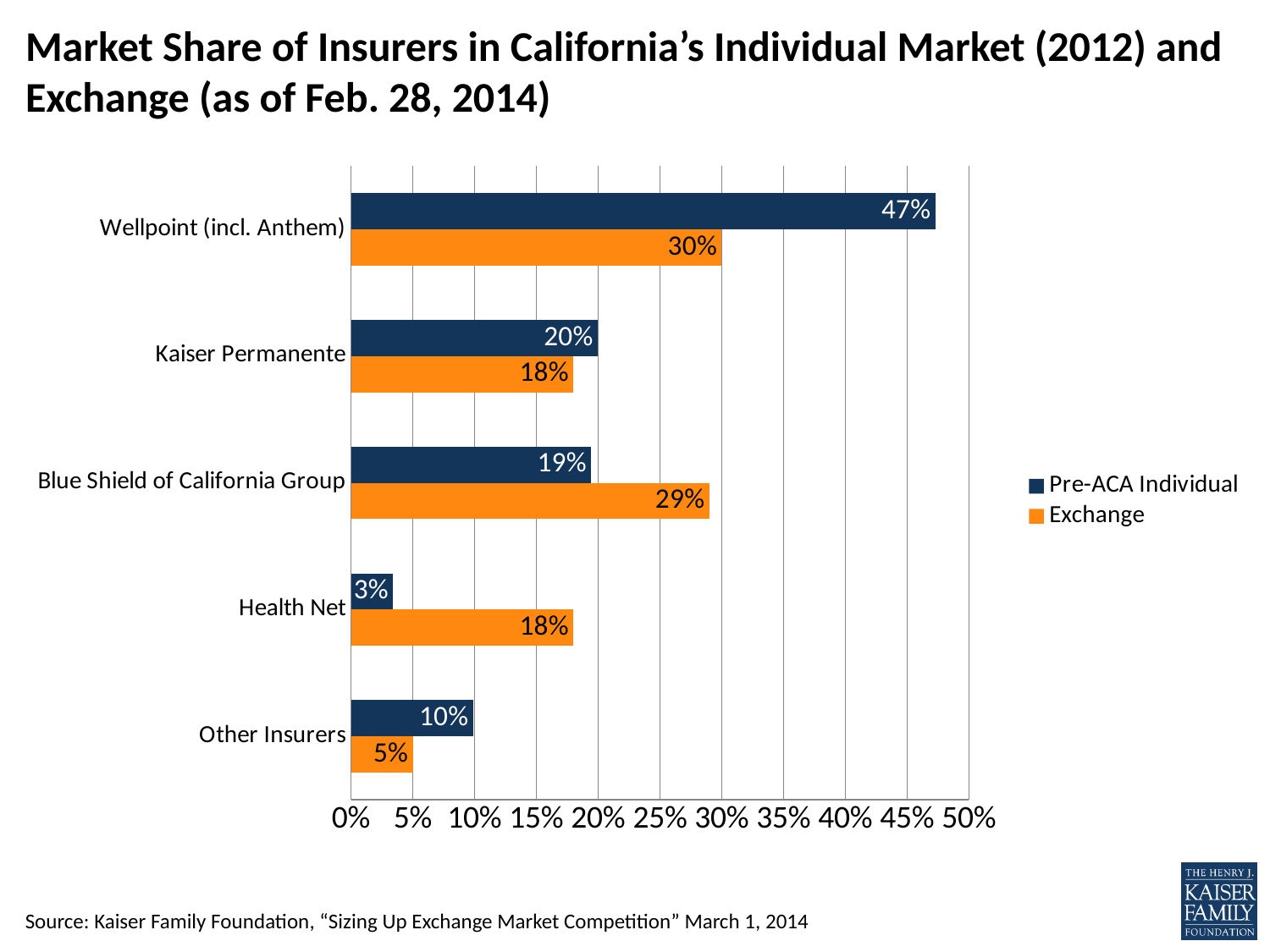
What kind of chart is shown on the slide? Bar chart Which is larger for Blue Shield of California Group: the Pre-ACA Individual share or the Exchange share? Exchange What is the Exchange market share for Blue Shield of California Group? 29% Which colour represents the Exchange series? Orange Which insurer has the lowest Pre-ACA Individual market share? Health Net What is the Pre-ACA Individual market share for Health Net? 3% How many insurer categories are shown on the chart? 5 Is the Exchange share for Kaiser Permanente greater or less than 20%? less How many series does the legend list? 2 Which insurer has the highest Exchange market share? Wellpoint (incl. Anthem) What is the Pre-ACA Individual market share for Wellpoint (incl. Anthem)? 47% What is the difference between Wellpoint's Pre-ACA Individual share and its Exchange share? 17 percentage points